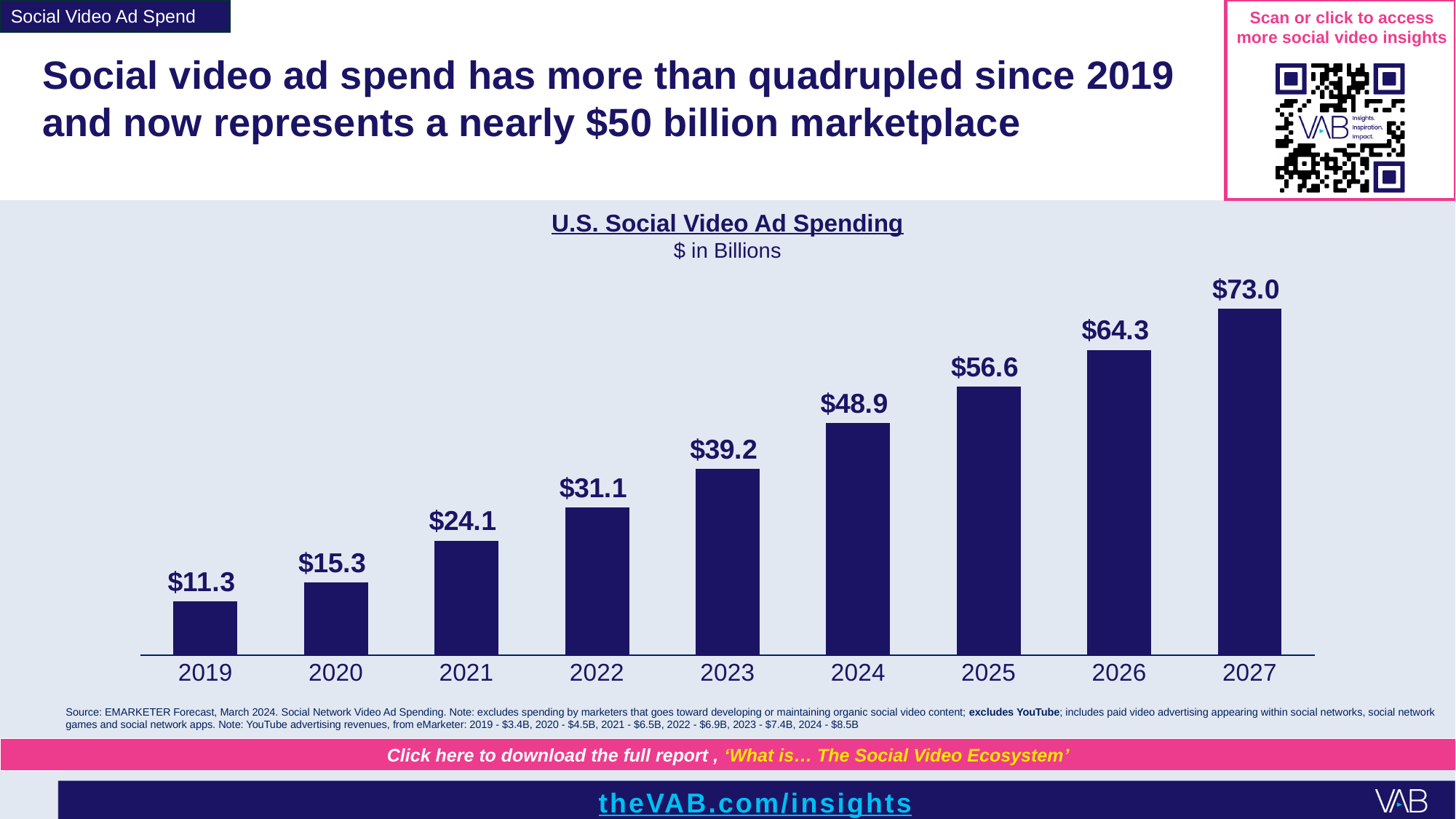
Do the values rise or fall from 2019 to 2027? Rise What is the title of the chart? U.S. Social Video Ad Spending What is the U.S. social video ad spending value shown for 2027? $73.0 What is the U.S. social video ad spending value shown for 2019? $11.3 Which year has a larger value, 2021 or 2025? 2025 Which year has the highest U.S. social video ad spending in the chart? 2027 Which year has the lowest U.S. social video ad spending in the chart? 2019 How many years are shown on the x axis of the chart? 9 What is the difference between the 2027 and 2019 values in the chart? $61.7 What kind of chart is shown on the slide? Bar chart What is the difference between the 2023 and 2022 values in the chart? $8.1 What is the U.S. social video ad spending value shown for 2024? $48.9